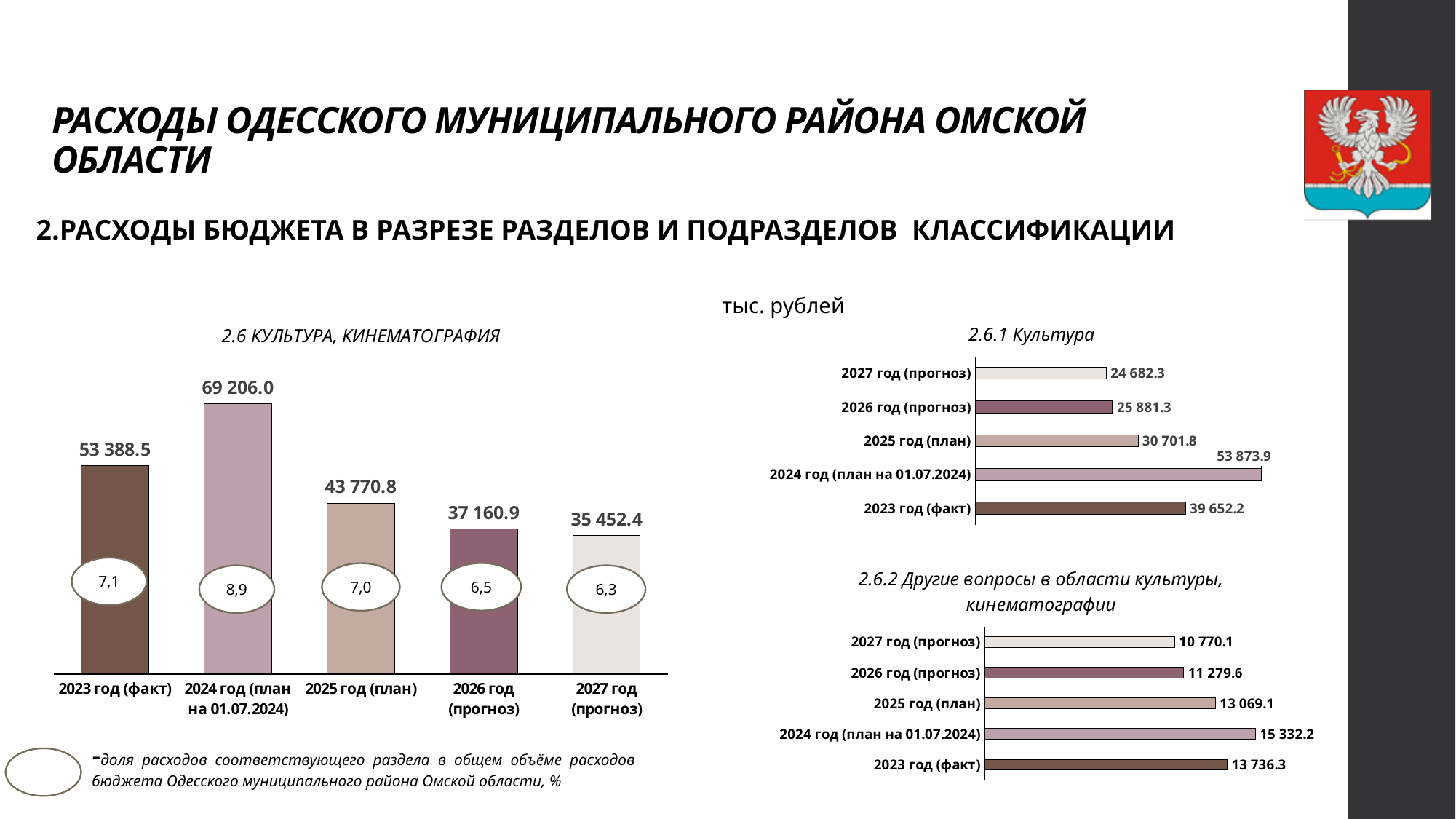
In the chart '2.6.2 Другие вопросы в области культуры, кинематографии', which is larger: the value for 2023 год (факт) or 2025 год (план)? 2023 год (факт) In the chart '2.6.1 Культура', which year has the highest value? 2024 год (план на 01.07.2024) In the chart '2.6 КУЛЬТУРА, КИНЕМАТОГРАФИЯ', what share of total budget expenditure (in %) is shown in the circle for 2024 год (план на 01.07.2024)? 8,9 In the chart '2.6 КУЛЬТУРА, КИНЕМАТОГРАФИЯ', which year has the lowest value? 2027 год (прогноз) In the chart '2.6.1 Культура', what is the value for 2025 год (план)? 30 701.8 What kind of chart is '2.6.1 Культура'? Bar chart In the chart '2.6 КУЛЬТУРА, КИНЕМАТОГРАФИЯ', what is the value for 2024 год (план на 01.07.2024)? 69 206.0 In the chart '2.6 КУЛЬТУРА, КИНЕМАТОГРАФИЯ', what is the difference between the values for 2024 год (план на 01.07.2024) and 2023 год (факт)? 15 817.5 In the chart '2.6.1 Культура', what is the difference between the values for 2024 год (план на 01.07.2024) and 2023 год (факт)? 14 221.7 In the chart '2.6.2 Другие вопросы в области культуры, кинематографии', what is the value for 2027 год (прогноз)? 10 770.1 In the chart '2.6 КУЛЬТУРА, КИНЕМАТОГРАФИЯ', how many bars are plotted? 5 In the chart '2.6.2 Другие вопросы в области культуры, кинематографии', do the values rise or fall from 2024 год (план на 01.07.2024) to 2027 год (прогноз)? Fall